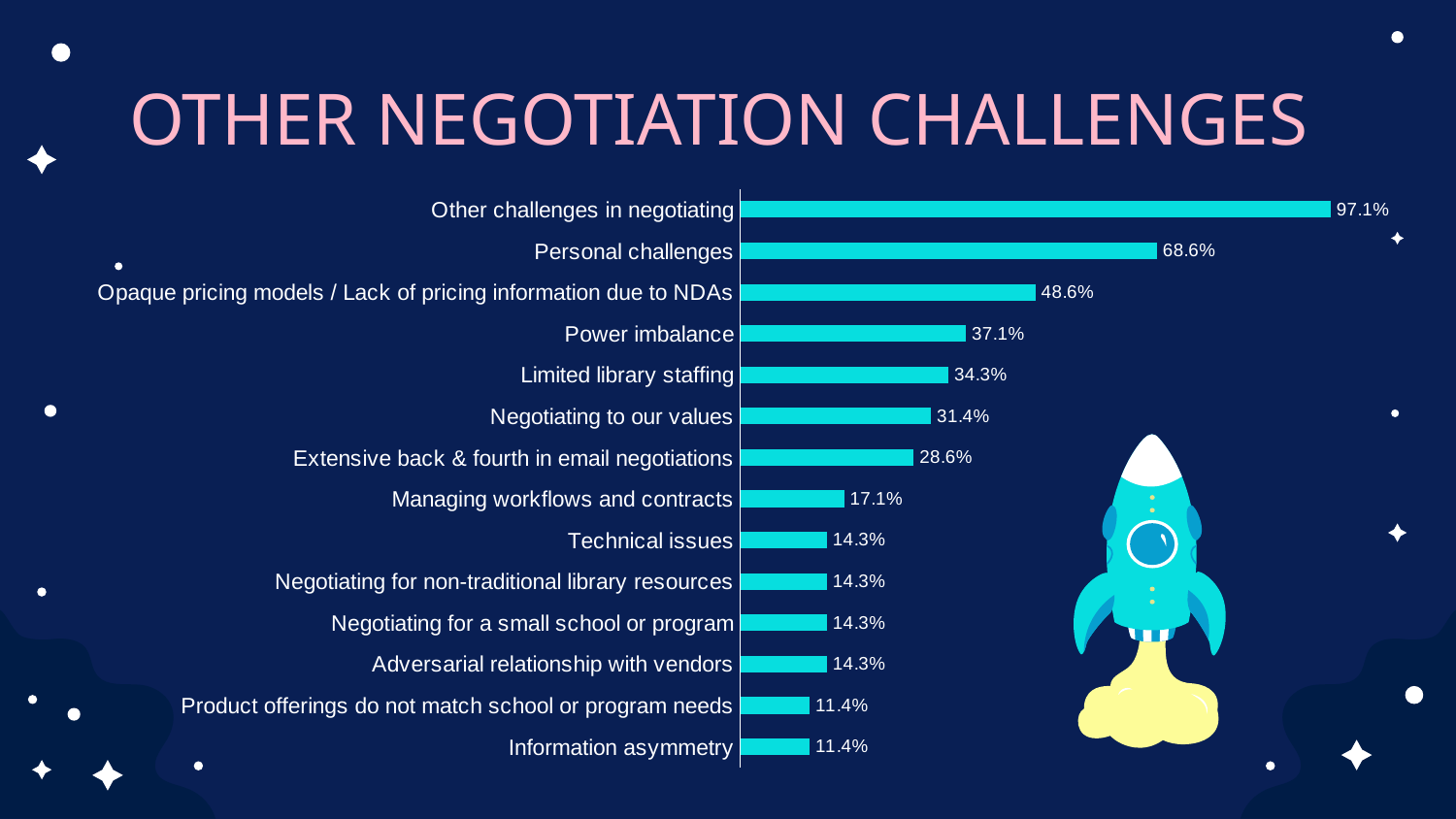
Which category has the highest value? Other challenges in negotiating What is the difference between Opaque pricing models / Lack of pricing information due to NDAs and Power imbalance? 11.5% What is the difference between Other challenges in negotiating and Personal challenges? 28.5% What is the value for Power imbalance? 37.1% What type of chart is shown on the slide? Bar chart What is the value for Personal challenges? 68.6% What is the value for Information asymmetry? 11.4% How many categories are shown in the chart? 14 Which is larger: Limited library staffing or Negotiating to our values? Limited library staffing What is the title of the slide? OTHER NEGOTIATION CHALLENGES What is the value for Managing workflows and contracts? 17.1% What is the lowest value shown in the chart? 11.4%